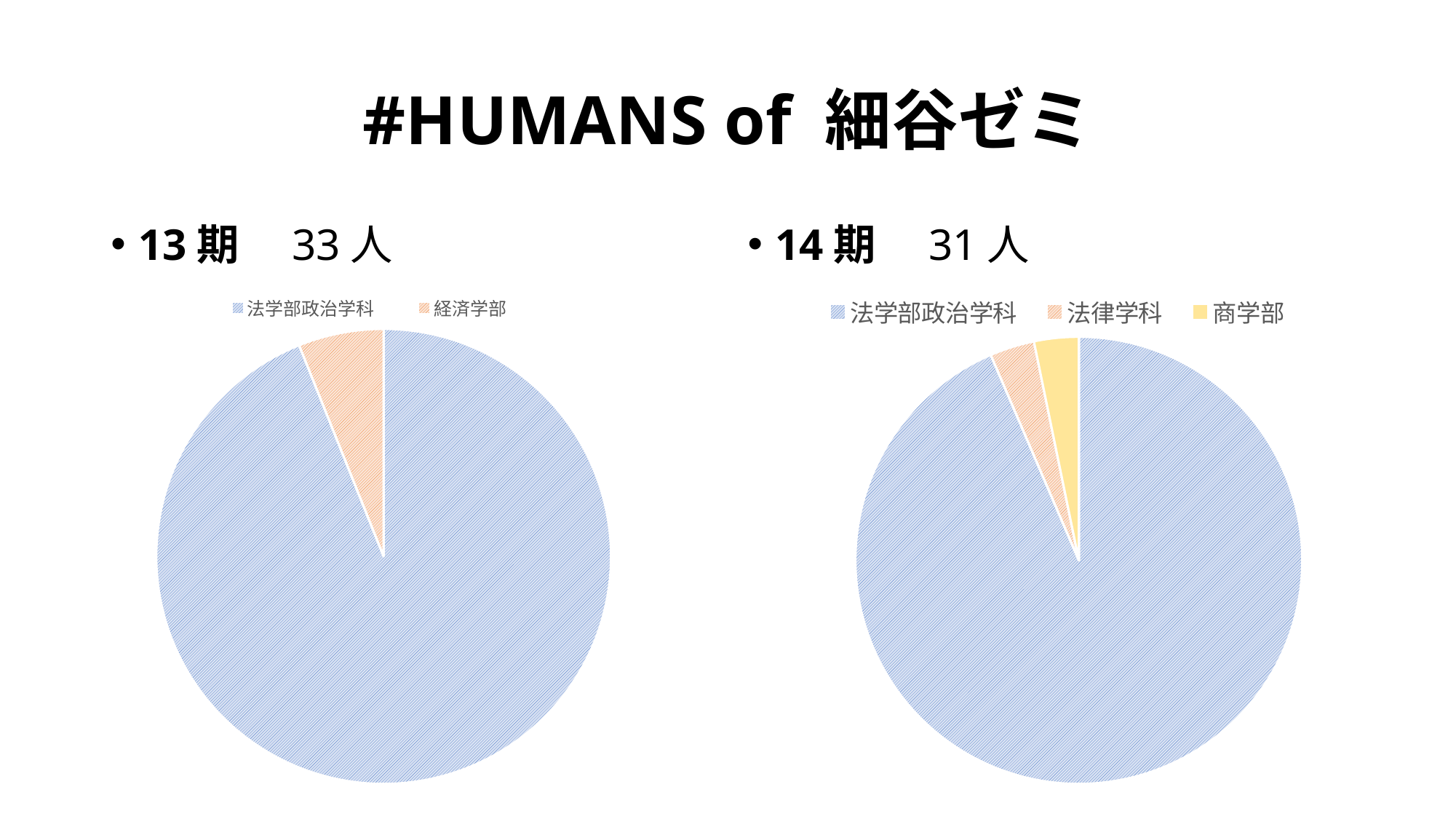
How many pie charts are on the slide? 2 In the right pie chart (14期), which slice is larger, 法学部政治学科 or 商学部? 法学部政治学科 In the left pie chart (13期), which category has the largest slice? 法学部政治学科 What kind of chart is shown under 13期 on the left of the slide? Pie chart In the right pie chart (14期), what are the legend entries? 法学部政治学科, 法律学科, 商学部 In the left pie chart (13期), which slice is larger, 法学部政治学科 or 経済学部? 法学部政治学科 In the left pie chart (13期), how many categories does the legend list? 2 In the right pie chart (14期), which category has the largest slice? 法学部政治学科 In the right pie chart (14期), which category is shown in yellow? 商学部 In the right pie chart (14期), how many categories does the legend list? 3 What kind of chart is shown under 14期 on the right of the slide? Pie chart In the left pie chart (13期), which category has the smallest slice? 経済学部